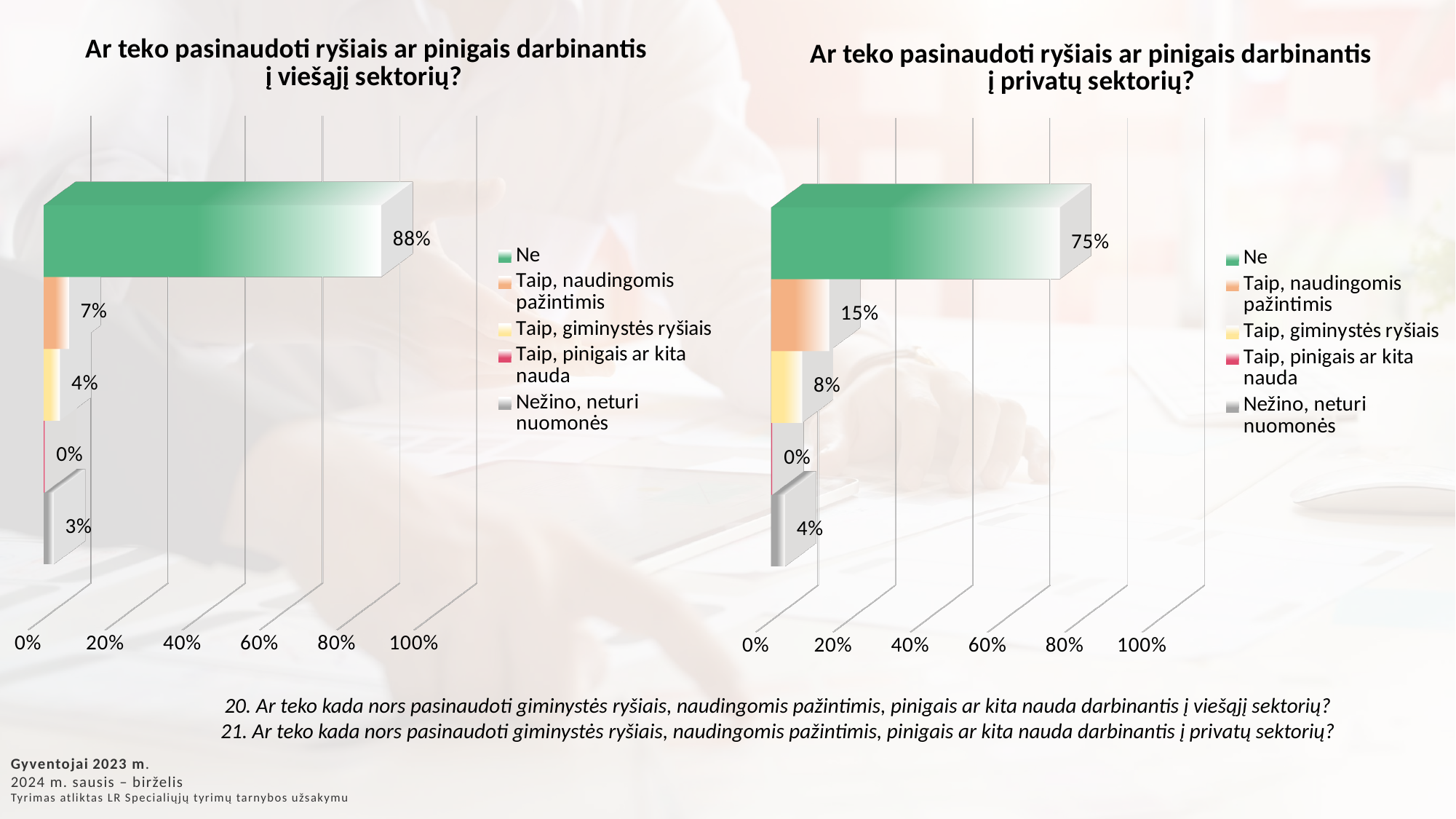
In the chart titled 'Ar teko pasinaudoti ryšiais ar pinigais darbinantis į viešąjį sektorių?', what is the value for 'Ne'? 88% What is the difference between the 'Ne' value in the left chart (viešąjį sektorių) and the 'Ne' value in the right chart (privatų sektorių)? 13% How many categories does the legend list in the left chart (viešąjį sektorių)? 5 In the right chart (privatų sektorių), which category has the highest value? Ne In the left chart (viešąjį sektorių), what colour is the bar for 'Ne'? Green What kind of chart is used in the right chart (privatų sektorių)? Bar chart In the left chart (viešąjį sektorių), which category has the lowest value? Taip, pinigais ar kita nauda In the left chart (viešąjį sektorių), what is the value for 'Taip, giminystės ryšiais'? 4% In the chart titled 'Ar teko pasinaudoti ryšiais ar pinigais darbinantis į privatų sektorių?', what is the value for 'Taip, naudingomis pažintimis'? 15% In the right chart (privatų sektorių), what is the value for 'Nežino, neturi nuomonės'? 4% In the right chart (privatų sektorių), what is the difference between 'Taip, naudingomis pažintimis' and 'Taip, giminystės ryšiais'? 7% Which is larger: 'Taip, naudingomis pažintimis' in the left chart (viešąjį sektorių) or in the right chart (privatų sektorių)? Right chart (privatų sektorių)